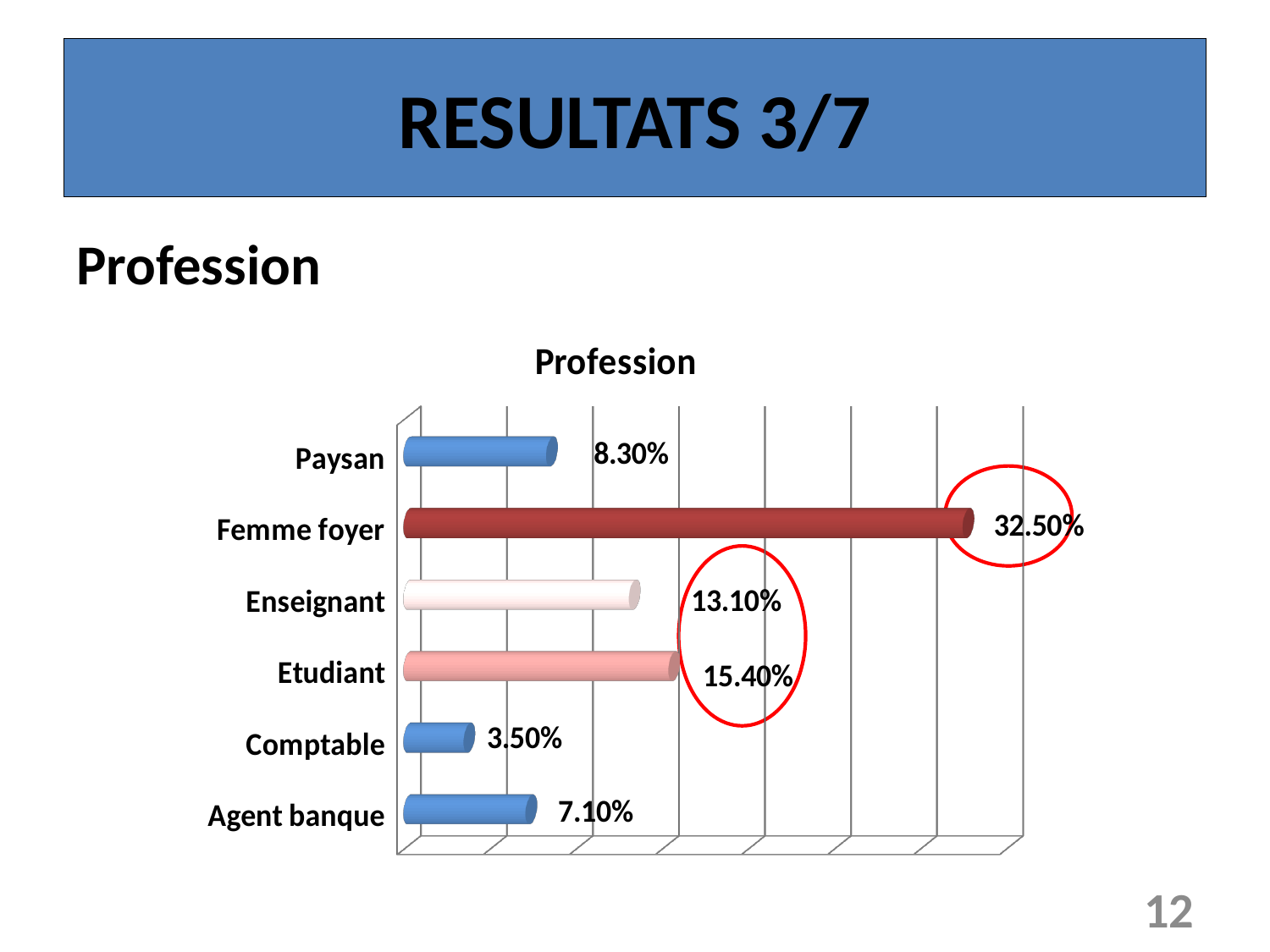
What is the title of the chart? Profession How many professions are shown in the chart? 6 What is the difference between the values for Paysan and Agent banque? 1.20% Which profession has the highest value? Femme foyer What is the value for Comptable? 3.50% Which is larger, the value for Enseignant or the value for Etudiant? Etudiant Which profession has the lowest value? Comptable What is the value for Femme foyer? 32.50% What kind of chart is this? Bar chart What is the difference between the values for Femme foyer and Etudiant? 17.10% What is the value for Agent banque? 7.10% What is the value for Etudiant? 15.40%